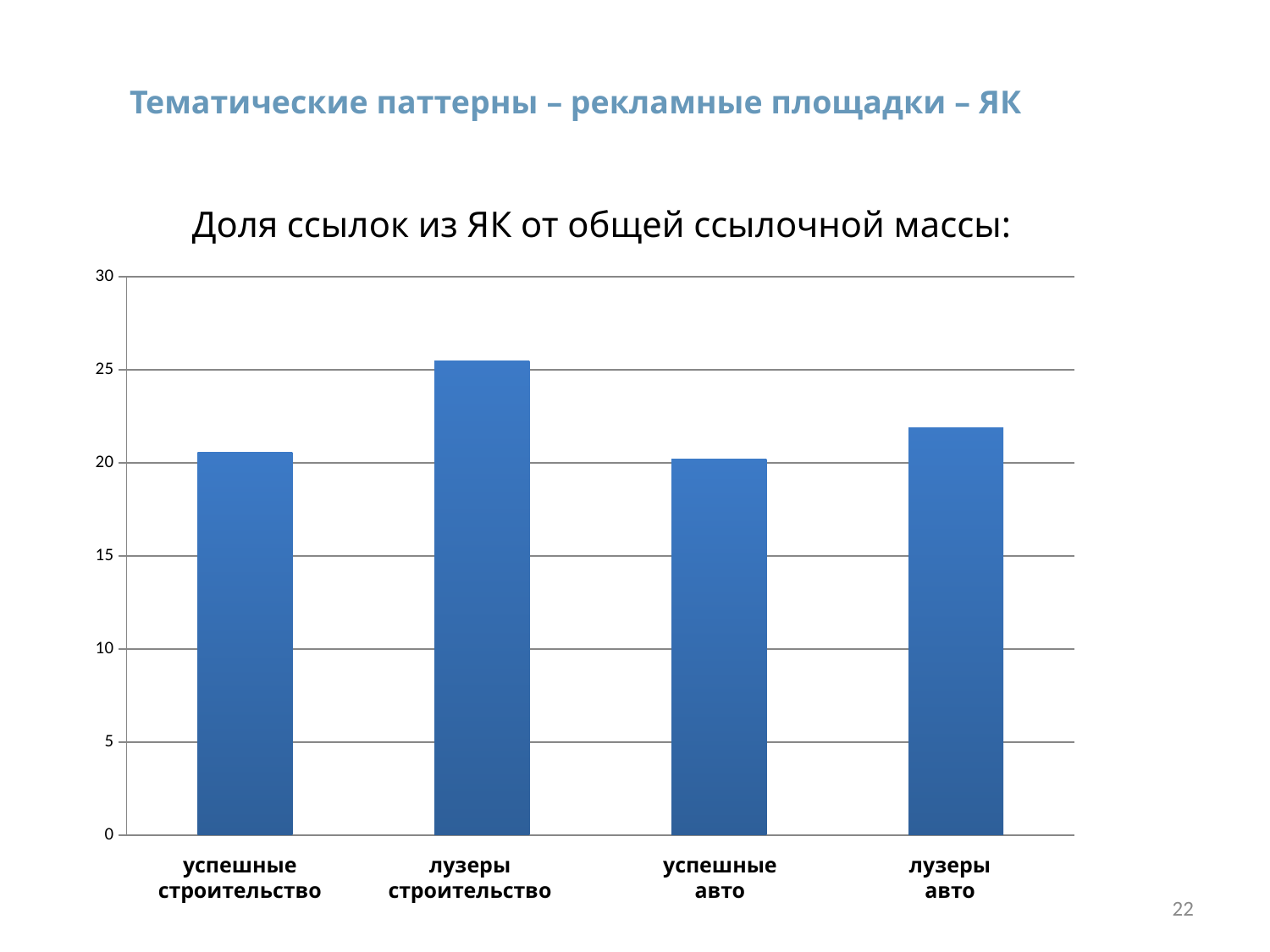
Is the value for успешные авто greater or less than 25? less Is the value for лузеры строительство greater or less than 25? greater How many categories are plotted in the chart? 4 Is the value for лузеры авто greater or less than 20? greater Which is larger, the value for лузеры строительство or the value for лузеры авто? лузеры строительство What kind of chart is shown on the slide? bar chart Which is larger, the value for лузеры строительство or the value for успешные строительство? лузеры строительство What is the title of the chart? Доля ссылок из ЯК от общей ссылочной массы: What is the maximum value shown on the vertical axis of the chart? 30 Which is larger, the value for лузеры авто or the value for успешные авто? лузеры авто Which category has the highest bar in the chart? лузеры строительство